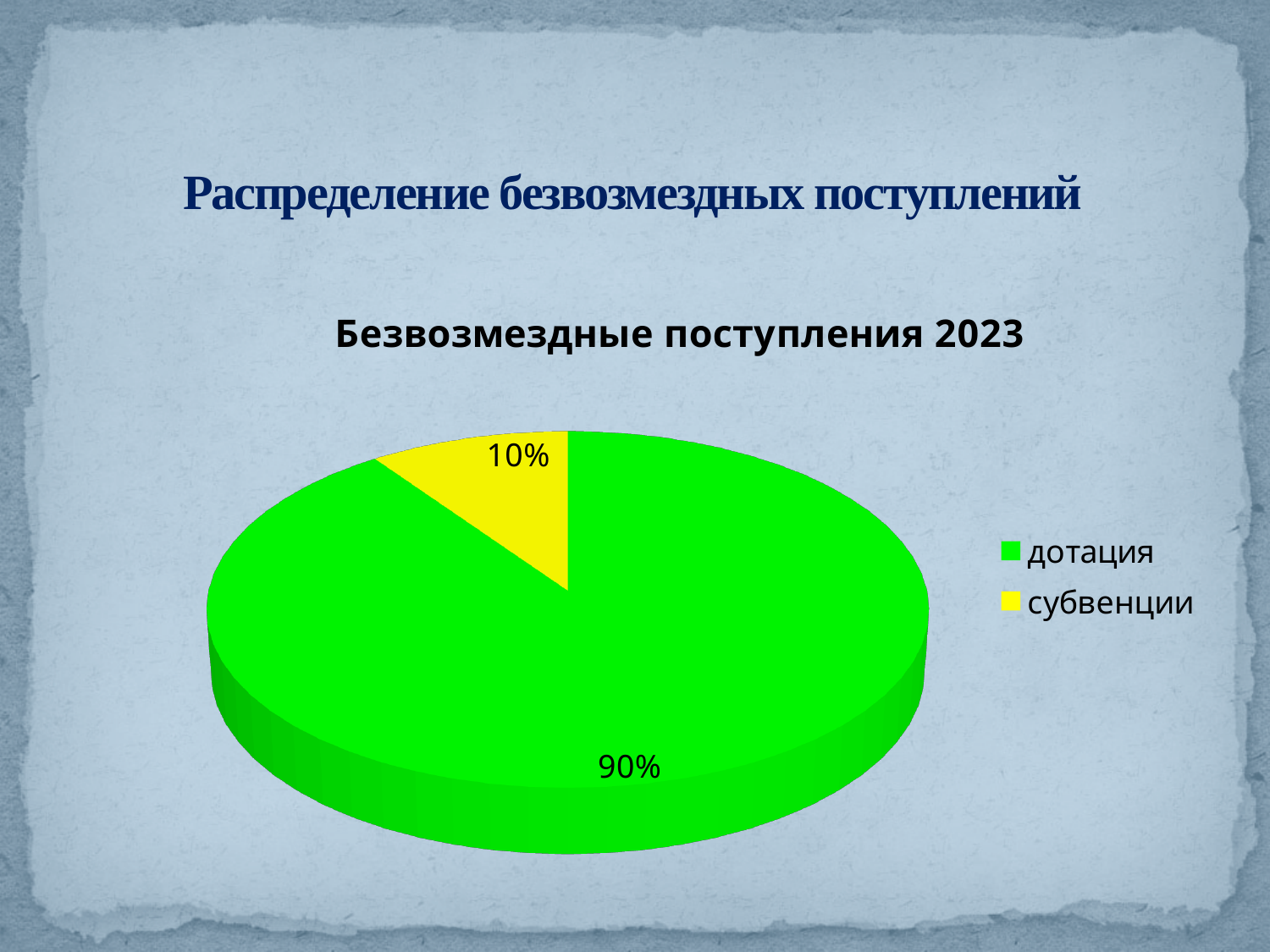
What colour is the slice for субвенции? yellow How many slices does the pie chart have? 2 What is the title of the chart? Безвозмездные поступления 2023 What kind of chart is shown on the slide? pie chart How many entries does the legend list? 2 What share of the pie does дотация account for? 90% Which category has the largest slice of the pie? дотация What share of the pie does субвенции account for? 10% What is the difference in percentage points between the дотация and субвенции slices? 80 Which is larger, the slice for дотация or the slice for субвенции? дотация Which category has the smallest slice of the pie? субвенции